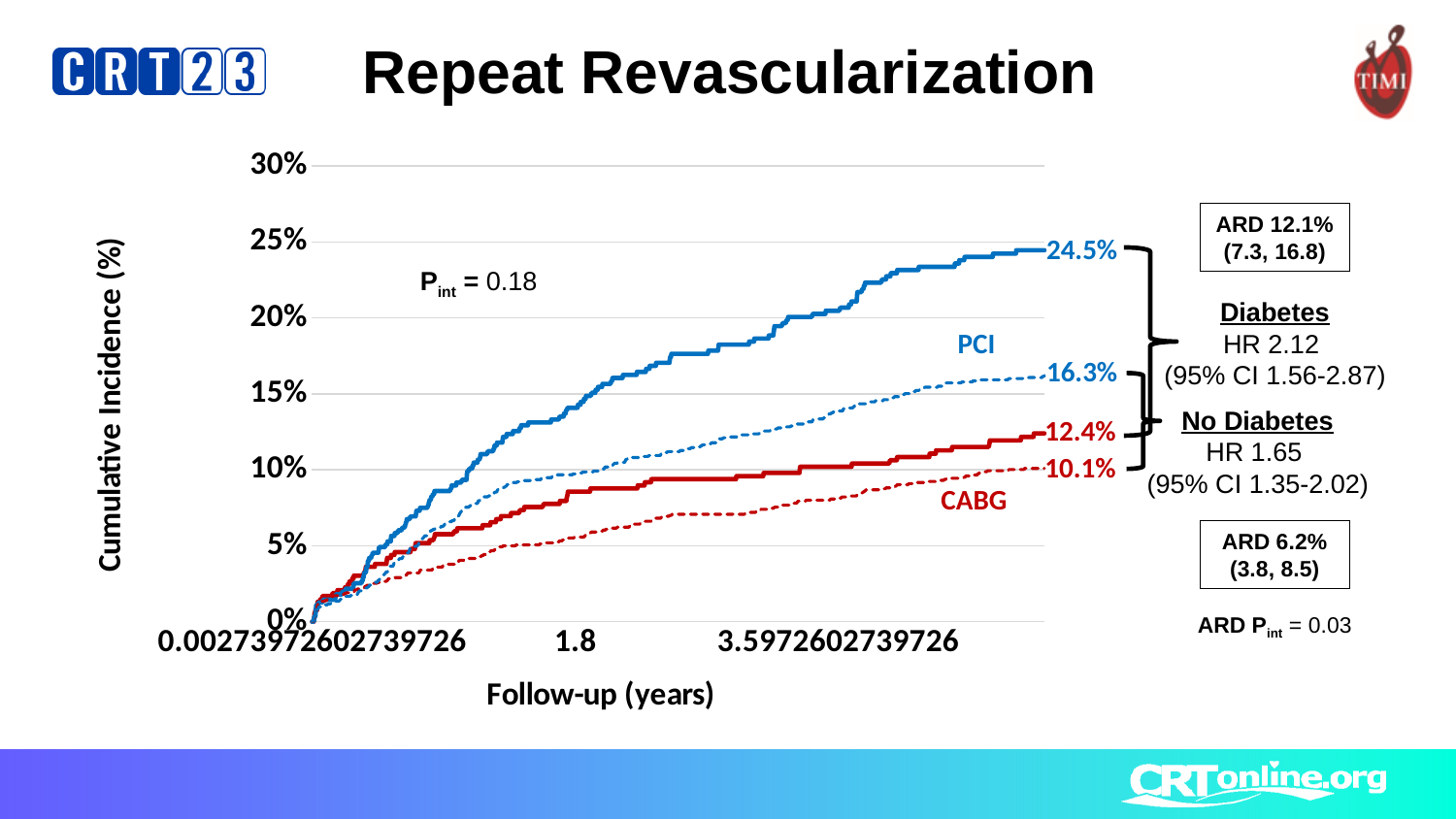
What is the final cumulative incidence value labelled on the solid PCI line (Diabetes group)? 24.5% Is the final value for the dashed PCI line greater or less than 15%? greater What is the difference between the final PCI and CABG values in the No Diabetes group (16.3% vs 10.1%)? 6.2% What is the final cumulative incidence value labelled on the dashed PCI line (No Diabetes group)? 16.3% Which line has the lowest cumulative incidence at the end of follow-up? CABG (No Diabetes), 10.1% Which line reaches the highest cumulative incidence at the end of follow-up? PCI (Diabetes), 24.5% What is the label of the y-axis? Cumulative Incidence (%) What is the difference between the final PCI and CABG values in the Diabetes group (24.5% vs 12.4%)? 12.1% What is the final cumulative incidence value labelled on the solid CABG line (Diabetes group)? 12.4% How many curves are plotted on the chart? 4 What is the final cumulative incidence value labelled on the dashed CABG line (No Diabetes group)? 10.1% What kind of chart is shown on the slide? line chart